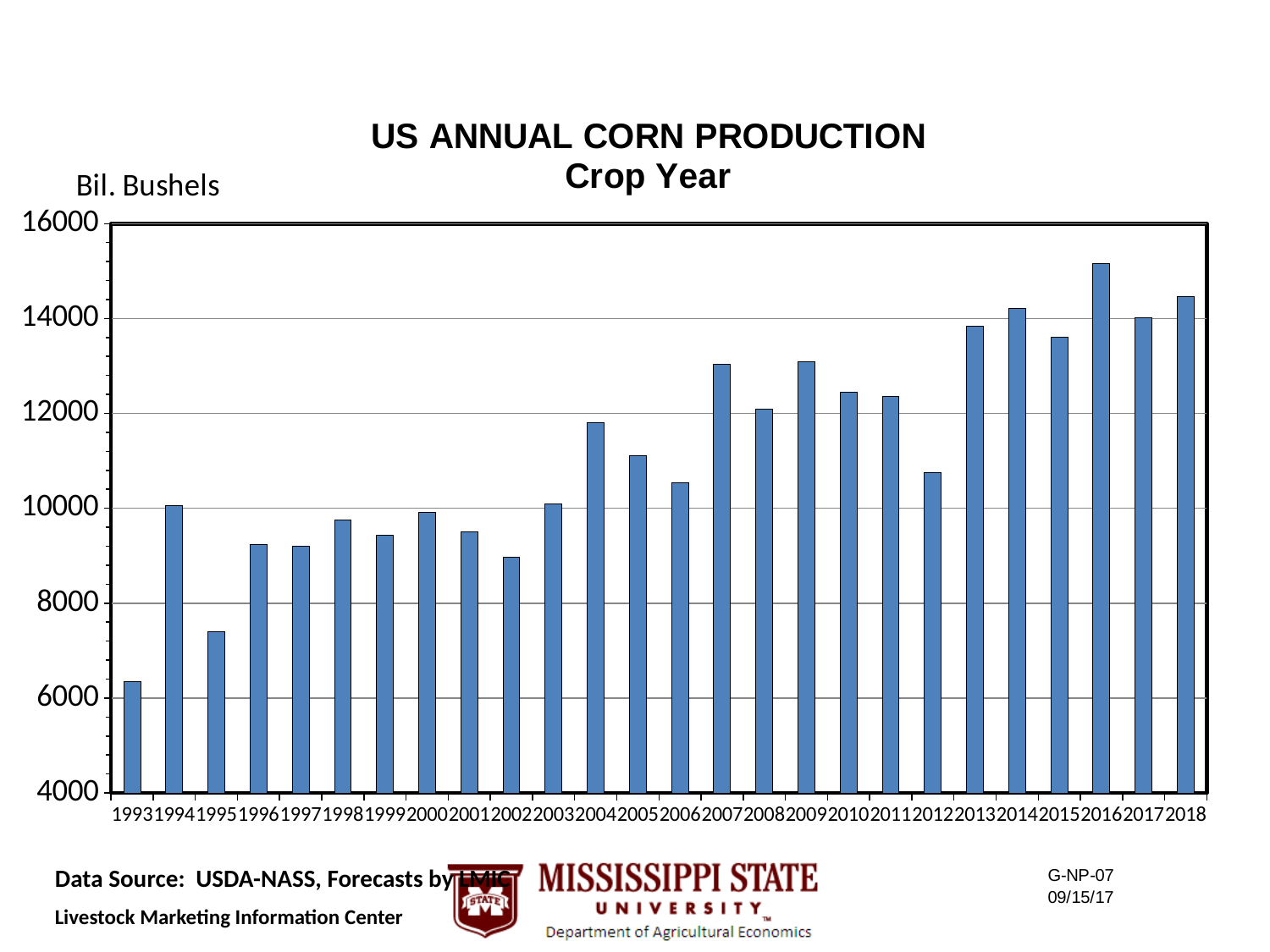
What unit is shown on the vertical axis label? Bil. Bushels What kind of chart is shown on the slide? bar chart Is the value for 1993 greater or less than 8000? less Which crop year has the lowest corn production? 1993 Which is larger, the value for 2016 or the value for 2017? 2016 How many crop years are plotted on the chart? 26 Which is larger, the value for 1995 or the value for 1996? 1996 Is the value for 2012 greater or less than 10000? greater Overall, do the values rise or fall from 1993 to 2018? rise Is the value for 2016 greater or less than 14000? greater Which crop year has the highest corn production? 2016